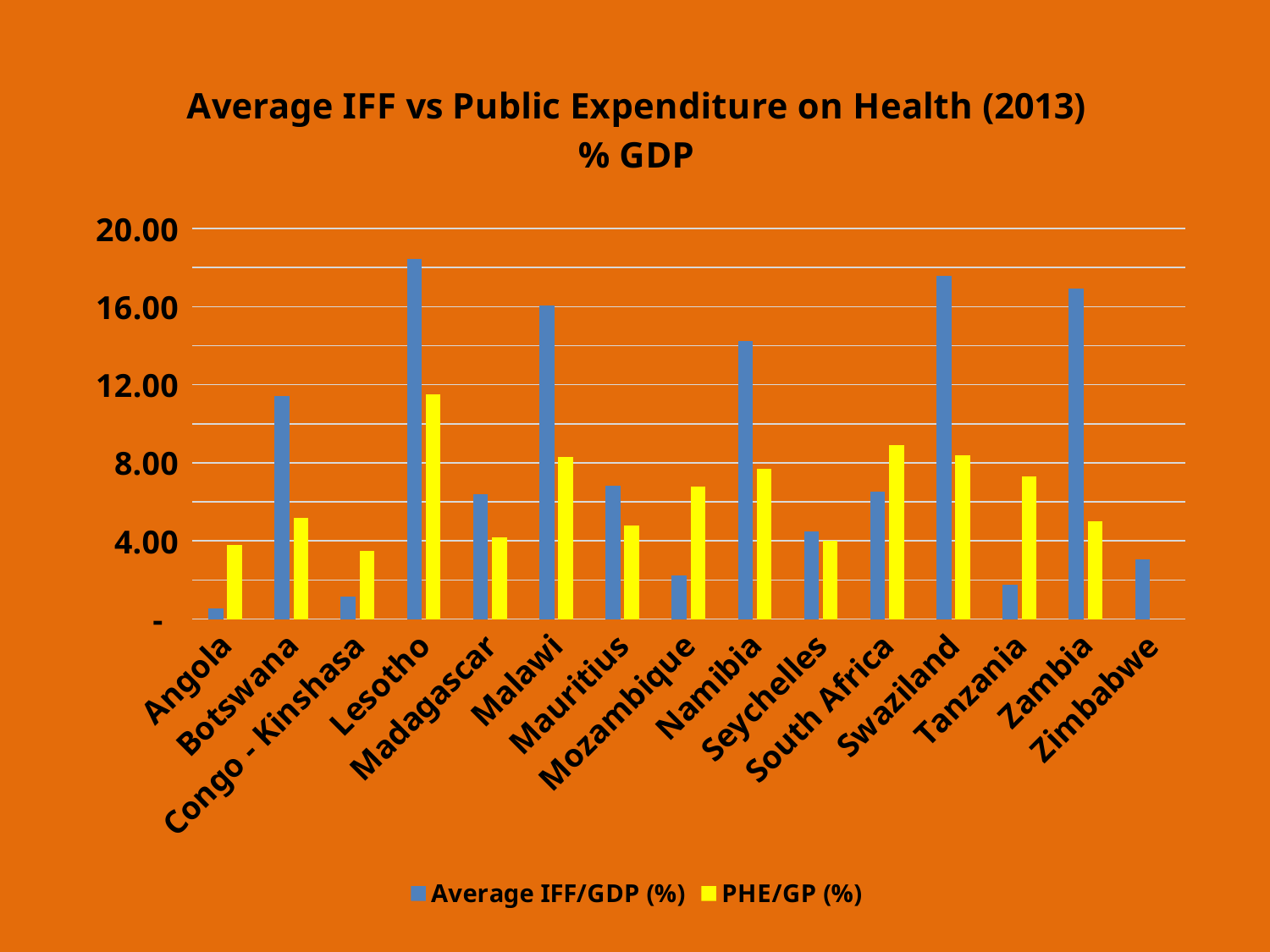
What colour are the bars for the PHE/GP (%) series? yellow How many series does the legend list? 2 Is the Average IFF/GDP (%) value for Mozambique greater or less than 4.00? less What kind of chart is shown on the slide? bar chart Is the PHE/GP (%) value for South Africa greater or less than 8.00? greater For Mozambique, which is larger: Average IFF/GDP (%) or PHE/GP (%)? PHE/GP (%) Which country has the lowest Average IFF/GDP (%) value? Angola Is the Average IFF/GDP (%) value for Namibia greater or less than 12.00? greater How many countries are shown on the x axis of the chart? 15 Which country has the highest Average IFF/GDP (%) value? Lesotho Which country has the highest PHE/GP (%) value? Lesotho For Botswana, which is larger: Average IFF/GDP (%) or PHE/GP (%)? Average IFF/GDP (%)